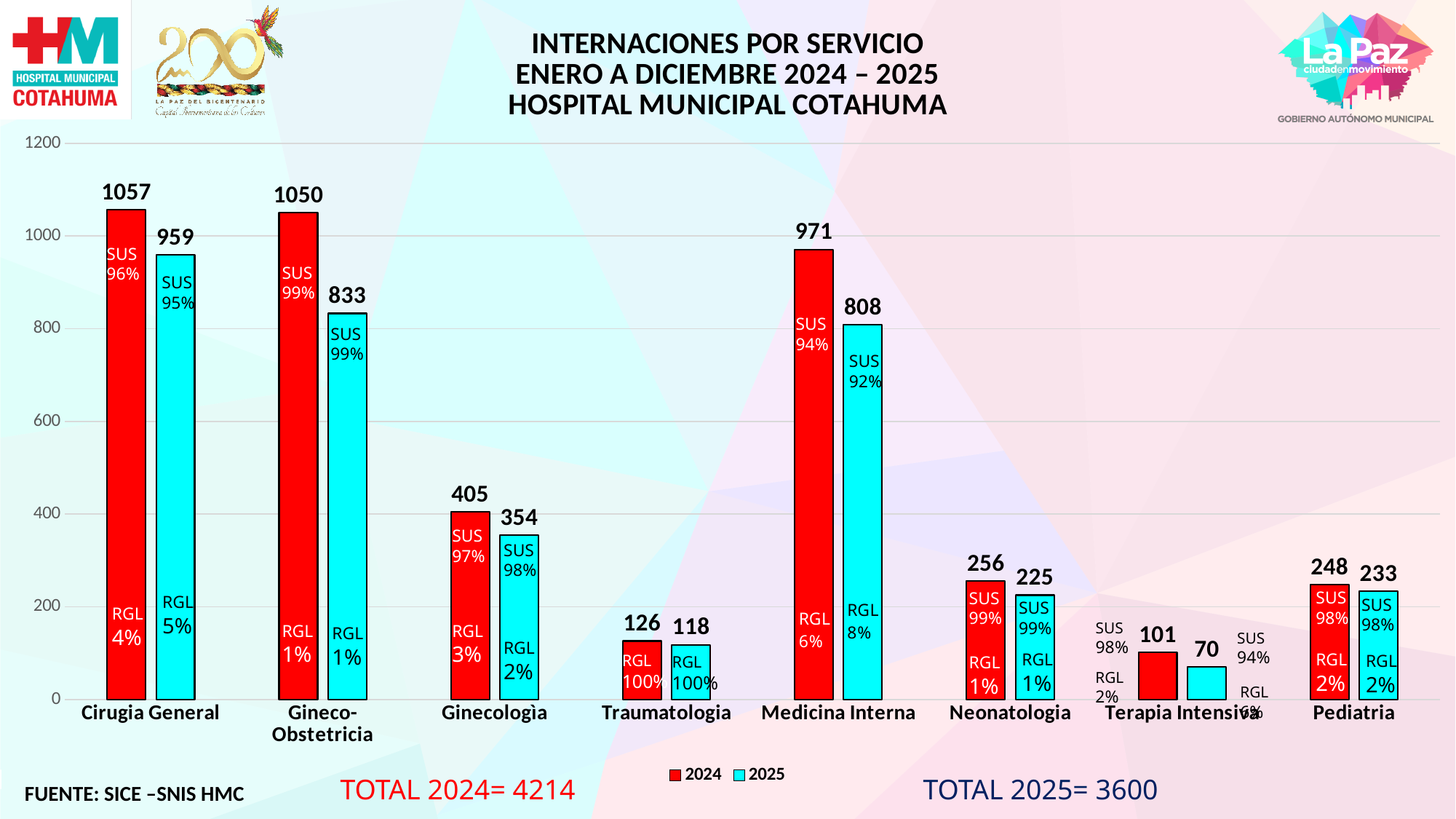
Which colour represents the 2025 series in the legend? Cyan How many series does the legend list? 2 Which service has the lowest value in 2025? Terapia Intensiva What is the difference between the 2024 and 2025 values for Medicina Interna? 163 What kind of chart is shown on the slide? Bar chart What is the value for Terapia Intensiva in 2025? 70 What is the value for Medicina Interna in 2025? 808 What is the difference between the 2024 and 2025 values for Gineco-Obstetricia? 217 Which is larger: the 2024 value for Ginecologìa or the 2024 value for Pediatria? Ginecologìa Which service has the highest value in 2024? Cirugia General How many services are shown on the x axis? 8 What is the value for Cirugia General in 2024? 1057